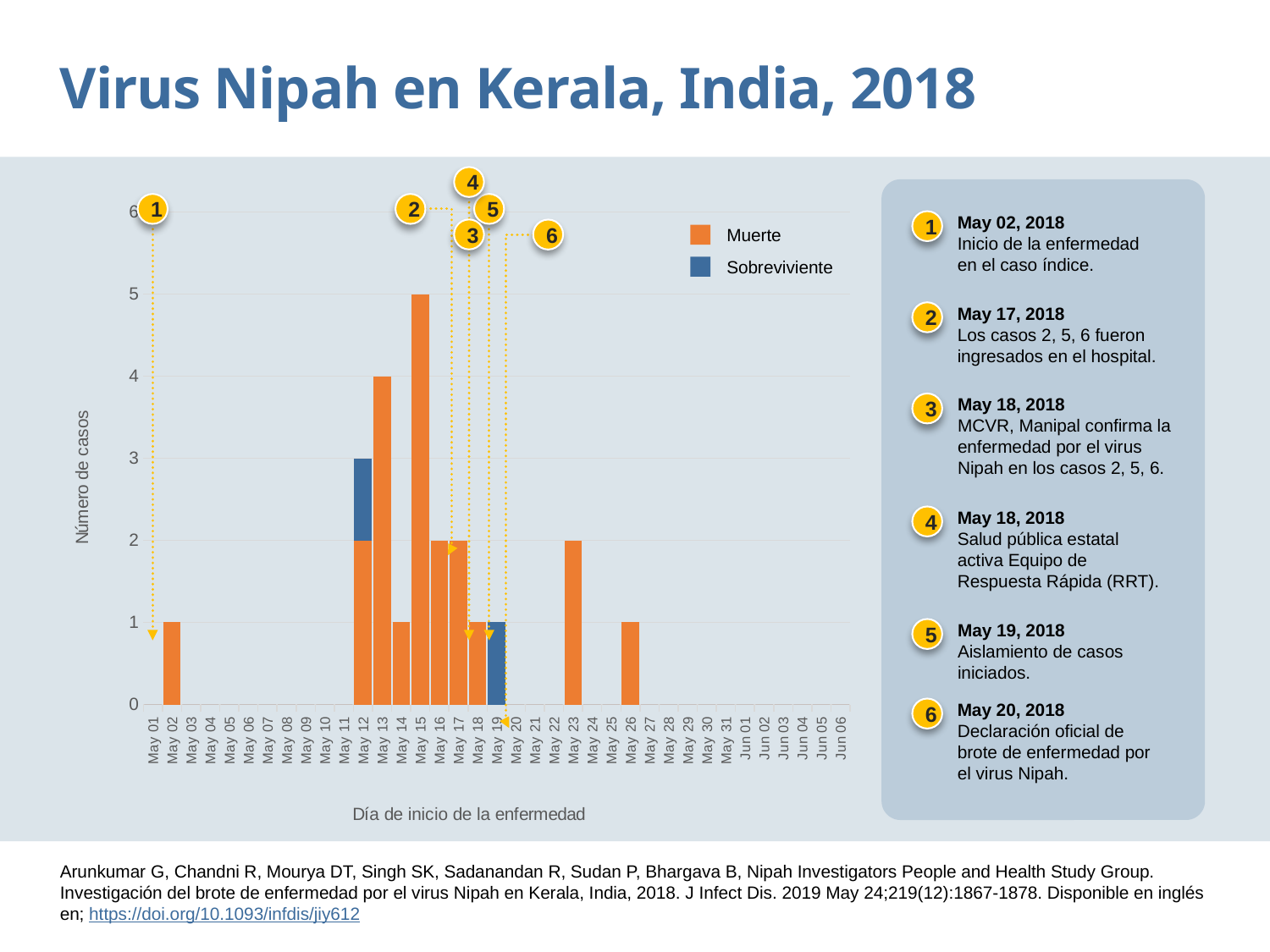
How many Sobreviviente cases are shown for May 19? 1 How many cases are shown for May 15? 5 How many cases are shown for May 02? 1 Which two series are listed in the legend? Muerte and Sobreviviente What is the total number of cases for May 12 (Muerte plus Sobreviviente)? 3 How many series does the legend list? 2 What is the label of the y axis? Número de casos Which has more cases, May 23 or May 26? May 23 What kind of chart is shown on the slide? bar chart How many Muerte cases are shown for May 13? 4 Which onset day has the highest number of cases? May 15 What is the difference between the number of cases on May 15 and on May 13? 1